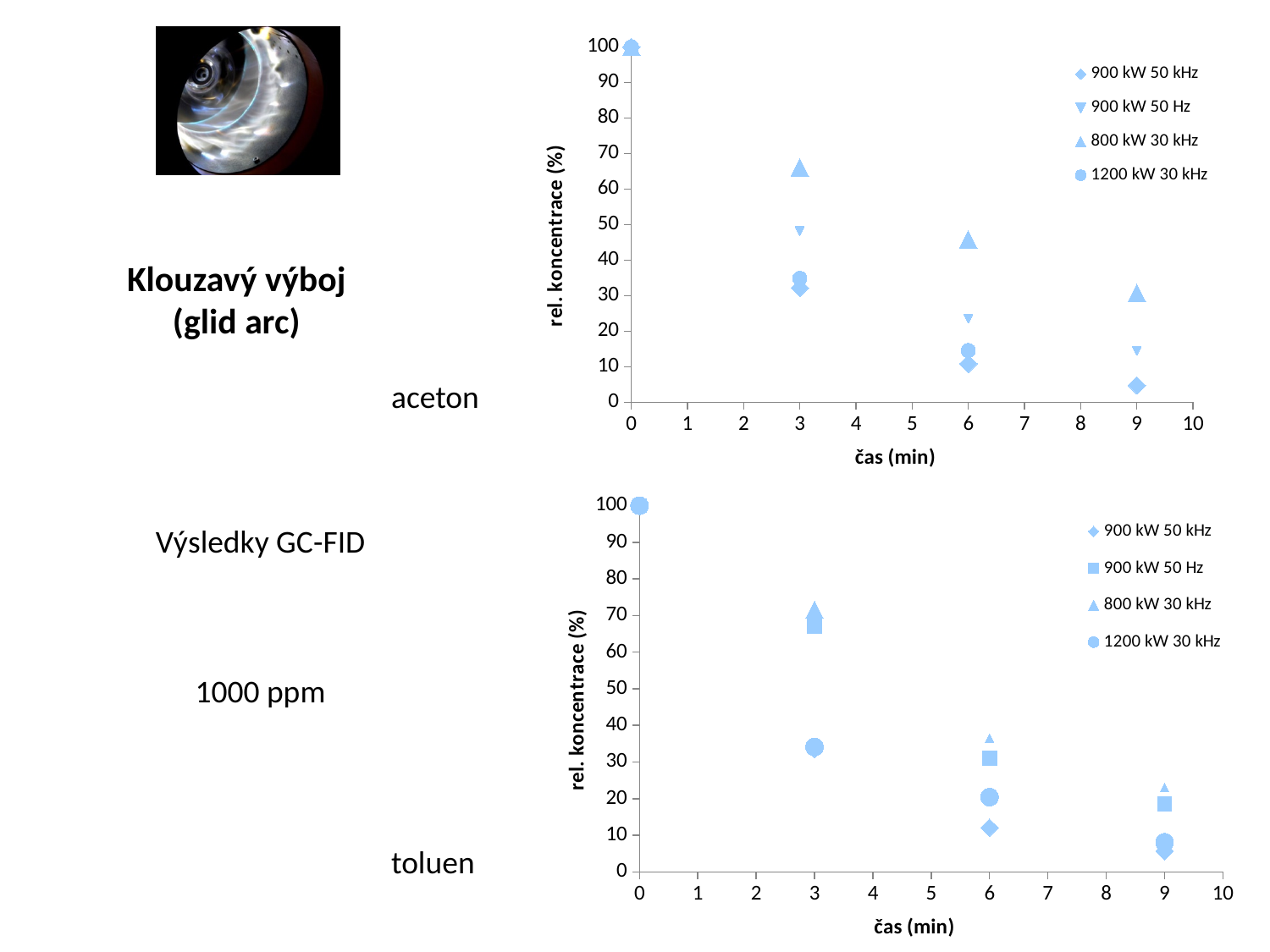
In the bottom chart (toluen), is the value for 1200 kW 30 kHz at 3 min greater or less than 30? greater In the top chart (aceton), which is larger at 9 min: 800 kW 30 kHz or 900 kW 50 kHz? 800 kW 30 kHz In the top chart (aceton), is the value for 900 kW 50 kHz at 9 min greater or less than 10? less In the bottom chart (toluen), do the values rise or fall as time increases? fall In the bottom chart (toluen), which series has the lowest value at 6 min? 900 kW 50 kHz In the top chart (aceton), is the value for 800 kW 30 kHz at 3 min greater or less than 60? greater What kind of chart is the top chart (aceton)? scatter chart In the top chart (aceton), which series has the highest value at 3 min? 800 kW 30 kHz What is the label of the x axis of the bottom chart (toluen)? čas (min) How many series does the legend of the bottom chart (toluen) list? 4